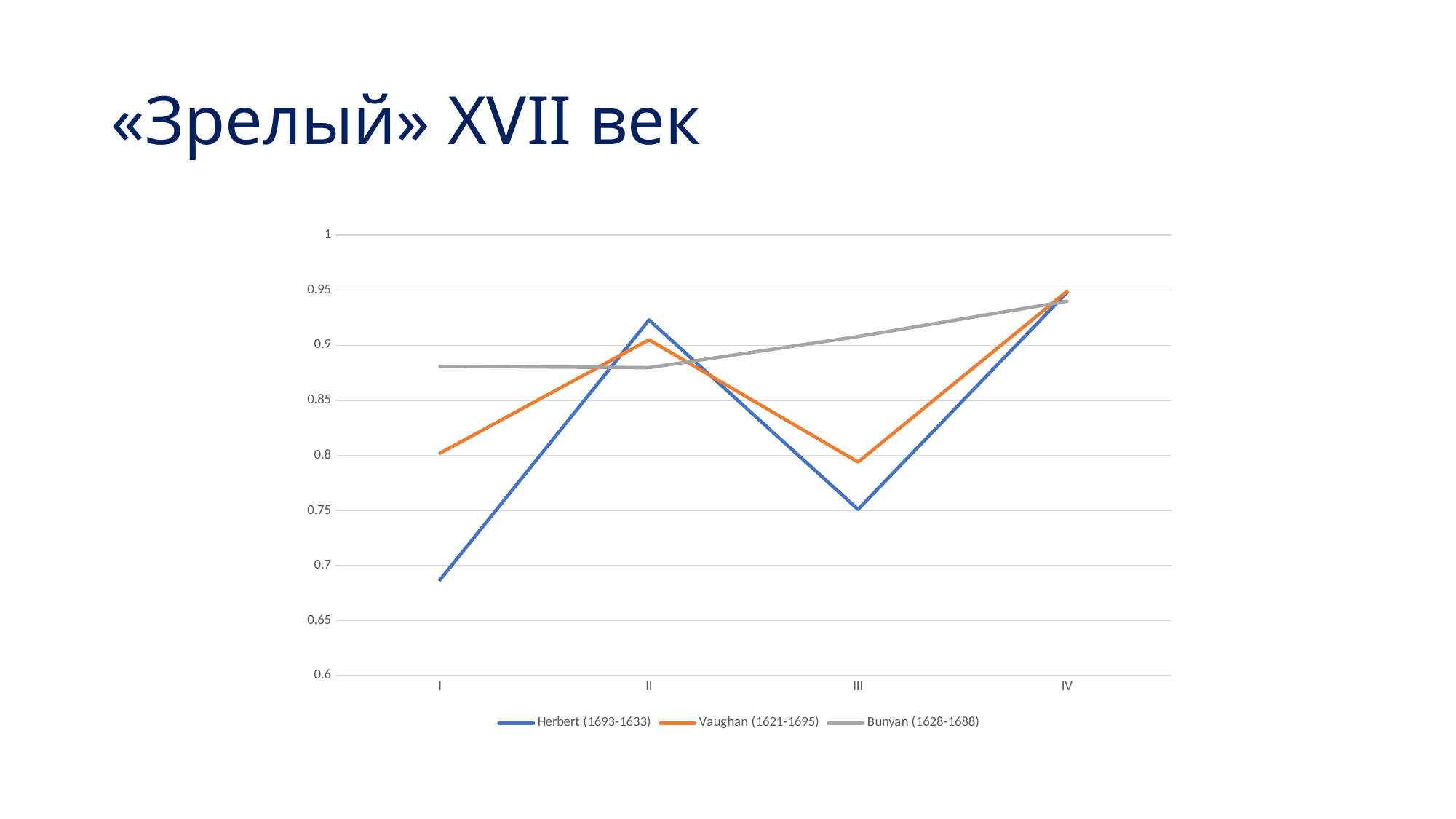
How many points are there along the x axis? 4 Is the value for Herbert (1693-1633) at III greater or less than 0.8? less At point I, which series has the larger value: Herbert (1693-1633) or Bunyan (1628-1688)? Bunyan (1628-1688) Is the value for Vaughan (1621-1695) at I greater or less than 0.85? less At point III, which series has the larger value: Herbert (1693-1633) or Bunyan (1628-1688)? Bunyan (1628-1688) Is the value for Bunyan (1628-1688) at I greater or less than 0.85? greater Does the Herbert (1693-1633) line rise or fall from II to III? fall At which point on the x axis does Herbert (1693-1633) reach its lowest value? I What kind of chart is shown on the slide? line chart How many series does the legend list? 3